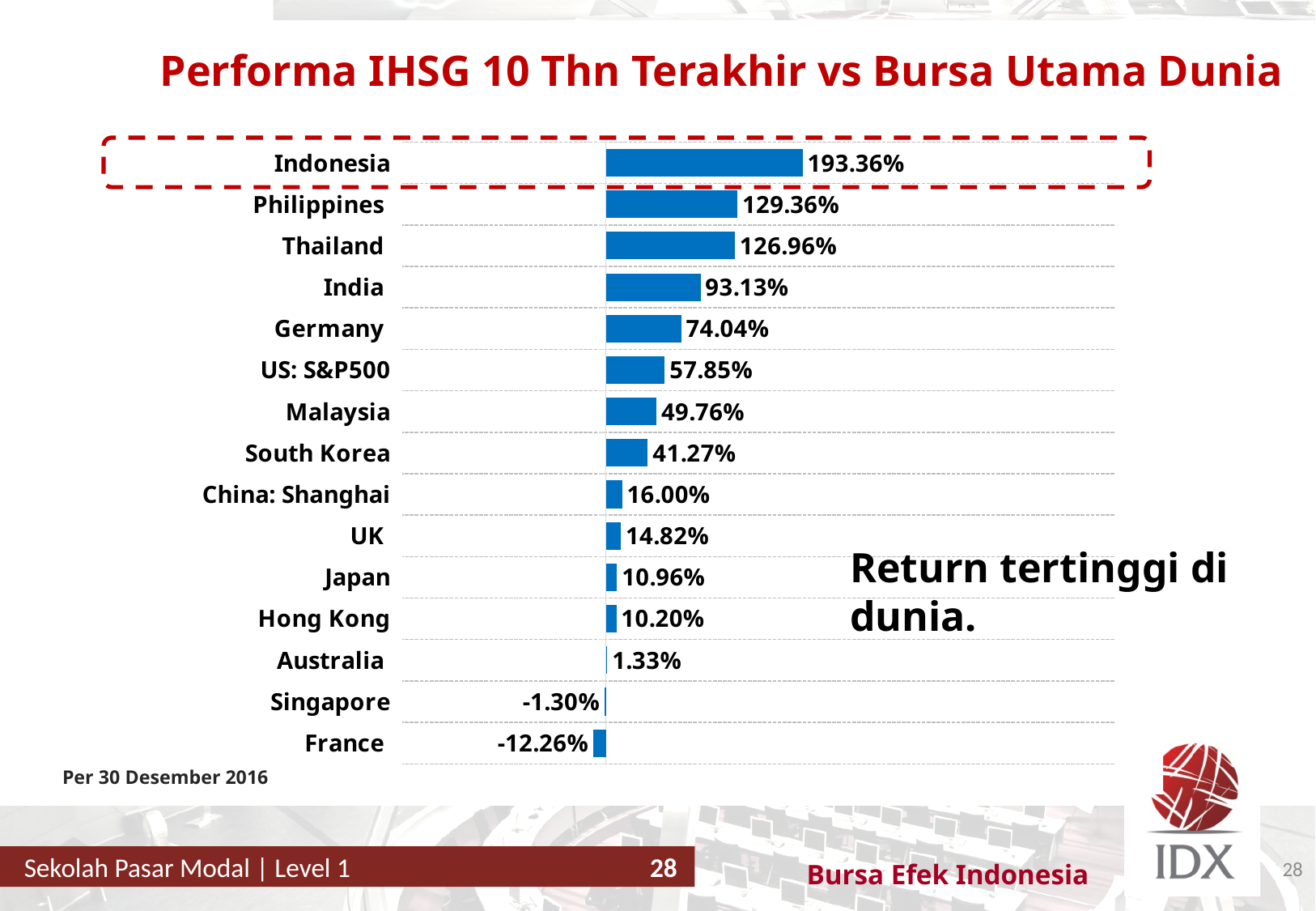
How many categories have a negative value? 2 What is the value for Germany? 74.04% How many categories are shown in the chart? 15 What kind of chart is shown on the slide? Bar chart What is the title of the slide? Performa IHSG 10 Thn Terakhir vs Bursa Utama Dunia Which category has the lowest value? France What is the difference between the values for Indonesia and Philippines? 64.00% Which is larger, the value for Malaysia or the value for South Korea? Malaysia Which category has the highest value? Indonesia What is the value for Indonesia? 193.36% What is the value for France? -12.26% What is the value for US: S&P500? 57.85%